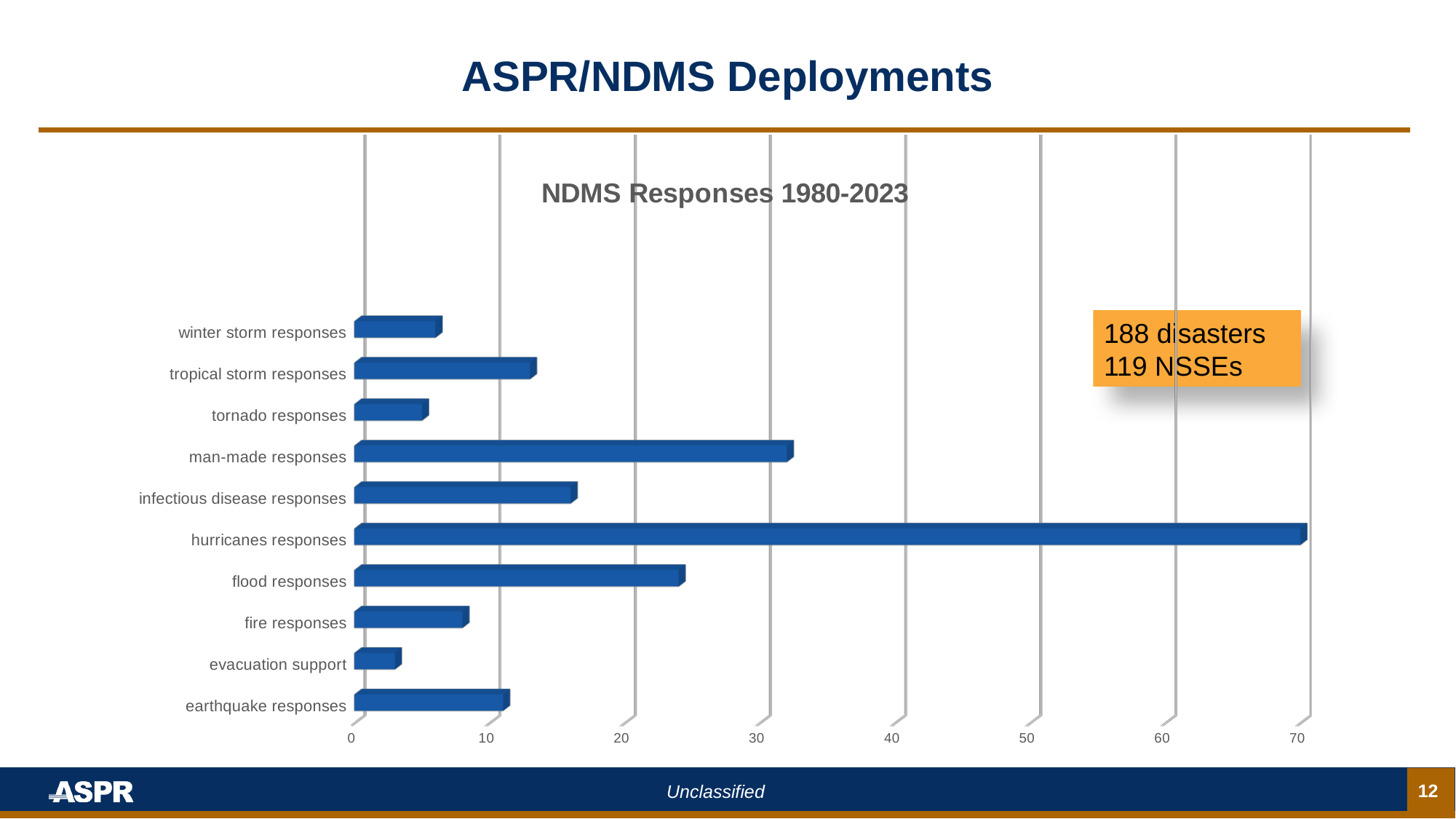
Which category has the highest value? hurricanes responses What kind of chart is shown on the slide? bar chart Which is larger, tropical storm responses or winter storm responses? tropical storm responses Which is larger, man-made responses or flood responses? man-made responses What is the title of the chart? NDMS Responses 1980-2023 Is the value for flood responses greater or less than 20? greater Is the value for fire responses greater or less than 10? less Which category has the lowest value? evacuation support How many categories are plotted in the chart? 10 Is the value for infectious disease responses greater or less than 20? less How many disasters does the text box on the chart say there were? 188 disasters